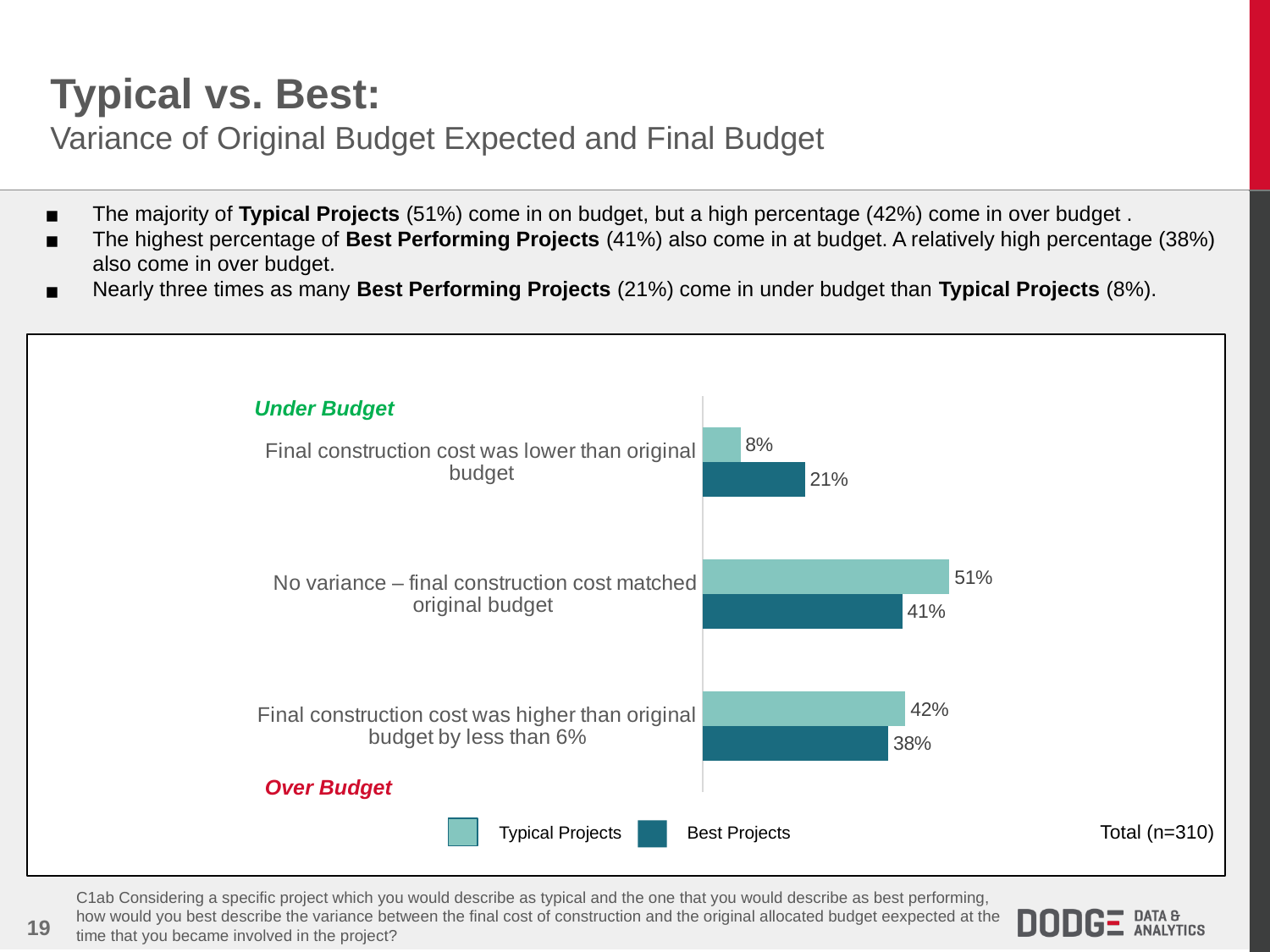
What kind of chart is shown on the slide? Bar chart What is the value for Best Projects in the 'No variance – final construction cost matched original budget' category? 41% Which series has the larger value in the 'Final construction cost was higher than original budget by less than 6%' category, Typical Projects or Best Projects? Typical Projects Which category has the highest value for Typical Projects? No variance – final construction cost matched original budget What is the difference between Best Projects and Typical Projects in the 'Final construction cost was lower than original budget' category? 13% How many series does the legend list? 2 What is the value for Best Projects in the 'Final construction cost was higher than original budget by less than 6%' category? 38% What is the value for Typical Projects in the 'Final construction cost was lower than original budget' category? 8% What sample size is noted on the chart? Total (n=310) How many categories are shown on the chart? 3 What is the difference between Typical Projects and Best Projects in the 'No variance – final construction cost matched original budget' category? 10% Which category has the lowest value for Best Projects? Final construction cost was lower than original budget